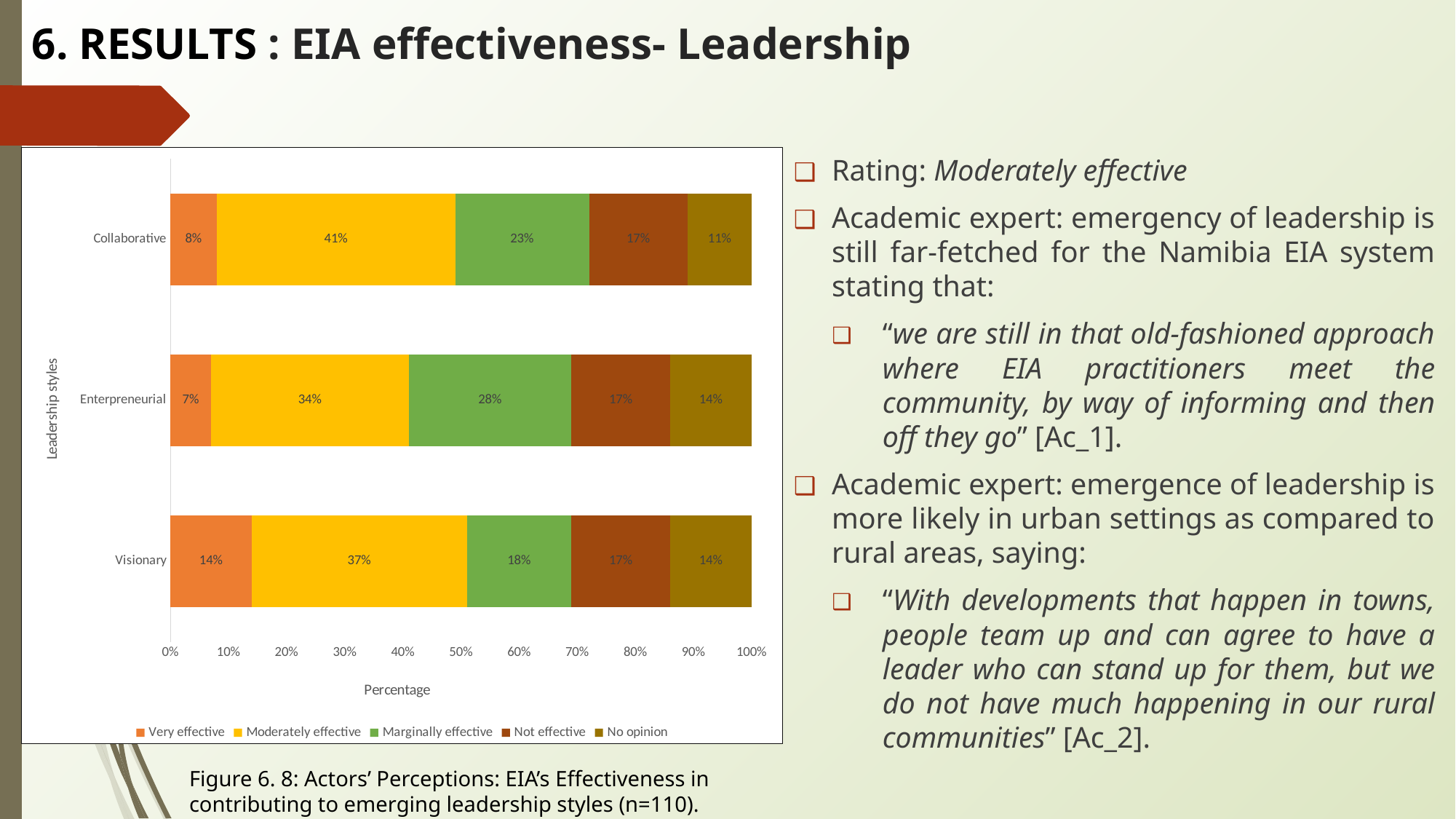
What percentage of respondents rated EIA as Moderately effective for the Collaborative leadership style? 41% What is the label of the x axis of the chart? Percentage What kind of chart is shown on the slide? Stacked bar chart Which leadership style has the highest Moderately effective percentage? Collaborative Which leadership style has the lowest Very effective percentage? Enterpreneurial What is the Marginally effective value for the Enterpreneurial leadership style? 28% What is the difference between the Moderately effective values for Collaborative and Enterpreneurial? 7% How many leadership styles are shown on the y axis? 3 What is the No opinion value for the Collaborative leadership style? 11% How many series does the legend list? 5 What is the Very effective value for the Visionary leadership style? 14% Which is larger: the Marginally effective value for Collaborative or for Visionary? Collaborative